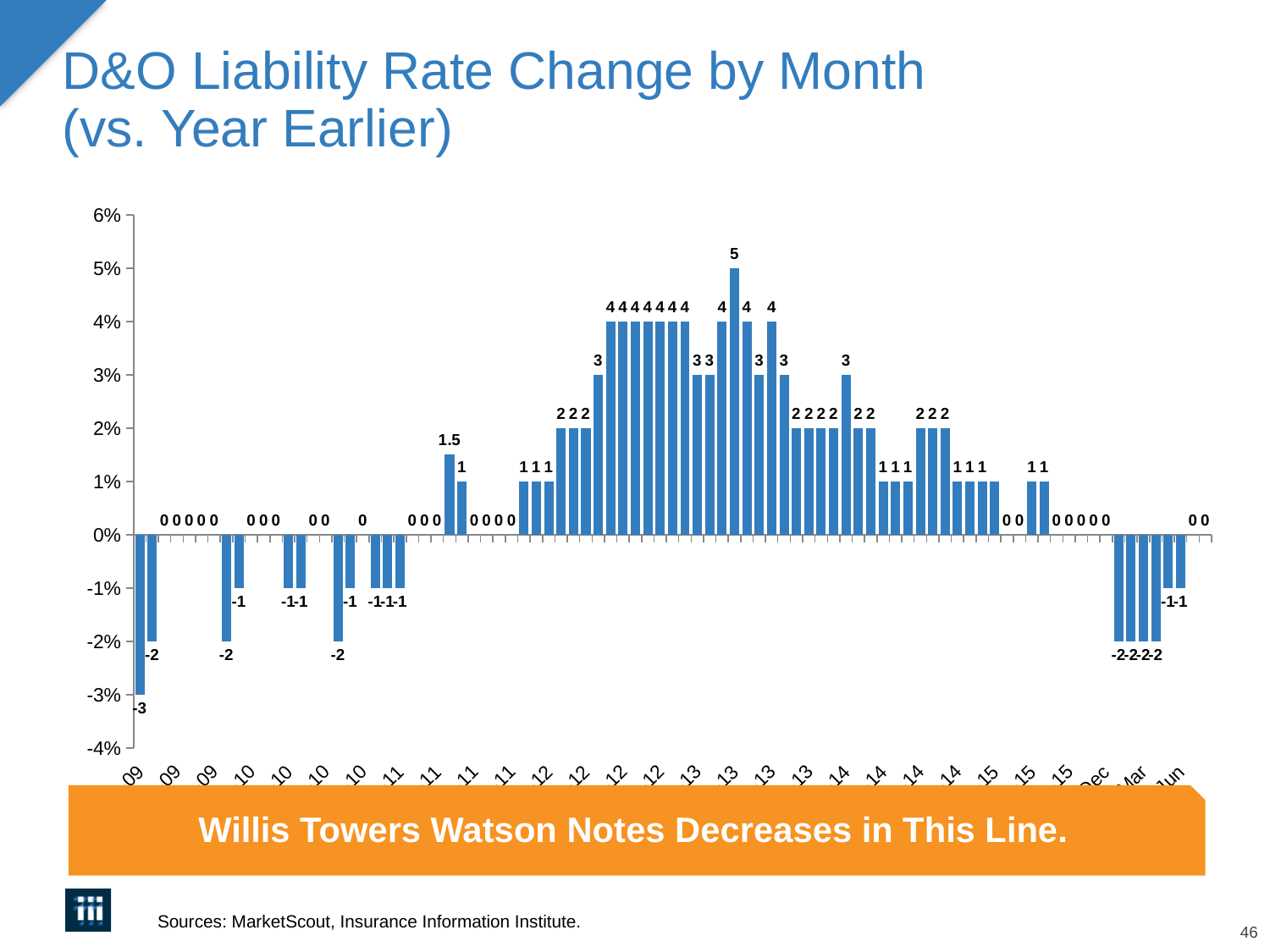
What is the value of the first bar on the left of the chart? -3 Is the tallest bar in the chart greater or less than 4%? greater What is the only non-integer data label shown on the chart? 1.5 What is the lowest value labeled on any bar in the chart? -3 What is the title of the chart? D&O Liability Rate Change by Month (vs. Year Earlier) What is the difference between the highest bar value (5) and the lowest bar value (-3)? 8 What is the highest value labeled on any bar in the chart? 5 After the bar labeled 5, do the values generally rise or fall toward the right end of the chart? fall Is the first bar on the left greater or less than -2%? less What kind of chart is shown on the slide? bar chart Which is higher, the first bar on the left (-3) or the last bar on the right (0)? the last bar (0) What sources are cited below the chart? MarketScout, Insurance Information Institute